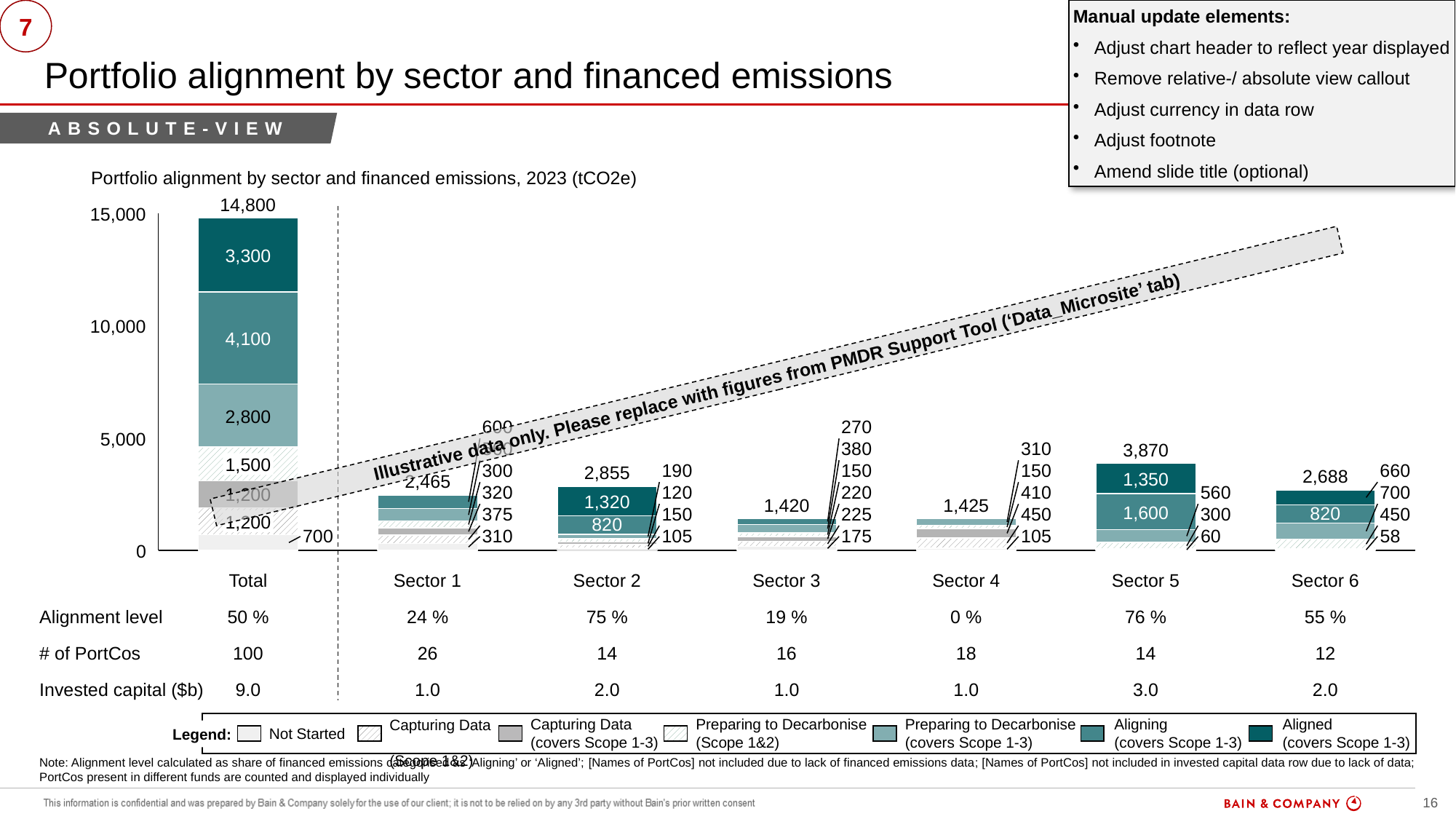
How many bars (categories) are shown on the x axis? 7 What is the total value shown above the Total bar? 14,800 What is the value of the Not Started segment in the Total bar? 700 What is the difference between the totals of Sector 5 and Sector 2? 1,015 What is the value of the Aligning (covers Scope 1-3) segment in the Sector 5 bar? 1,600 What is the value of the Aligned (covers Scope 1-3) segment in the Total bar? 3,300 What is the total financed emissions value shown above the Sector 5 bar? 3,870 Among Sector 1 to Sector 6, which sector has the highest total financed emissions? Sector 5 Which has a larger total, Sector 2 or Sector 6? Sector 2 Is the value of the Total bar greater or less than 10,000? greater What kind of chart is shown on the slide? Stacked bar chart How many series does the legend list? 7